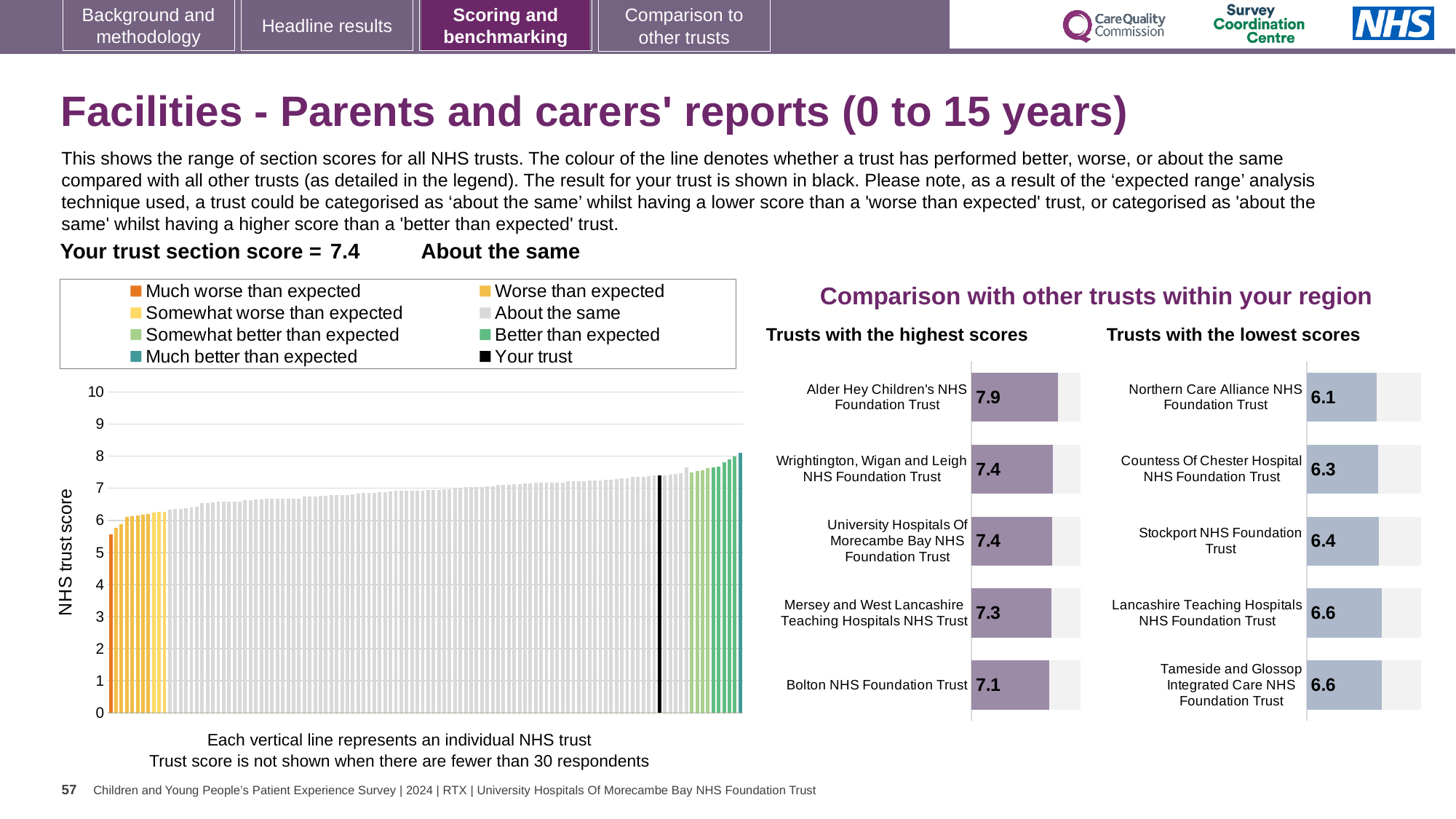
In the main 'NHS trust score' chart on the left, do the values rise or fall from left to right? rise In the 'Trusts with the highest scores' chart, how many trusts are shown? 5 How many entries does the legend of the main 'NHS trust score' chart list? 8 In the 'Trusts with the lowest scores' chart, which trust has the lowest score? Northern Care Alliance NHS Foundation Trust In the main 'NHS trust score' chart on the left, what is the section score for your trust? 7.4 In the 'Trusts with the highest scores' chart, which trust has the highest score? Alder Hey Children's NHS Foundation Trust What kind of chart is the main 'NHS trust score' chart on the left? bar chart In the main 'NHS trust score' chart on the left, is the value for the leftmost (orange) bar greater or less than 6? less In the 'Trusts with the highest scores' chart, what is the difference between the scores of Alder Hey Children's NHS Foundation Trust and Bolton NHS Foundation Trust? 0.8 In the 'Trusts with the lowest scores' chart, what is the score for Stockport NHS Foundation Trust? 6.4 In the 'Trusts with the highest scores' chart, what is the score for Alder Hey Children's NHS Foundation Trust? 7.9 In the 'Trusts with the lowest scores' chart, which has the larger score: Countess Of Chester Hospital NHS Foundation Trust or Lancashire Teaching Hospitals NHS Foundation Trust? Lancashire Teaching Hospitals NHS Foundation Trust